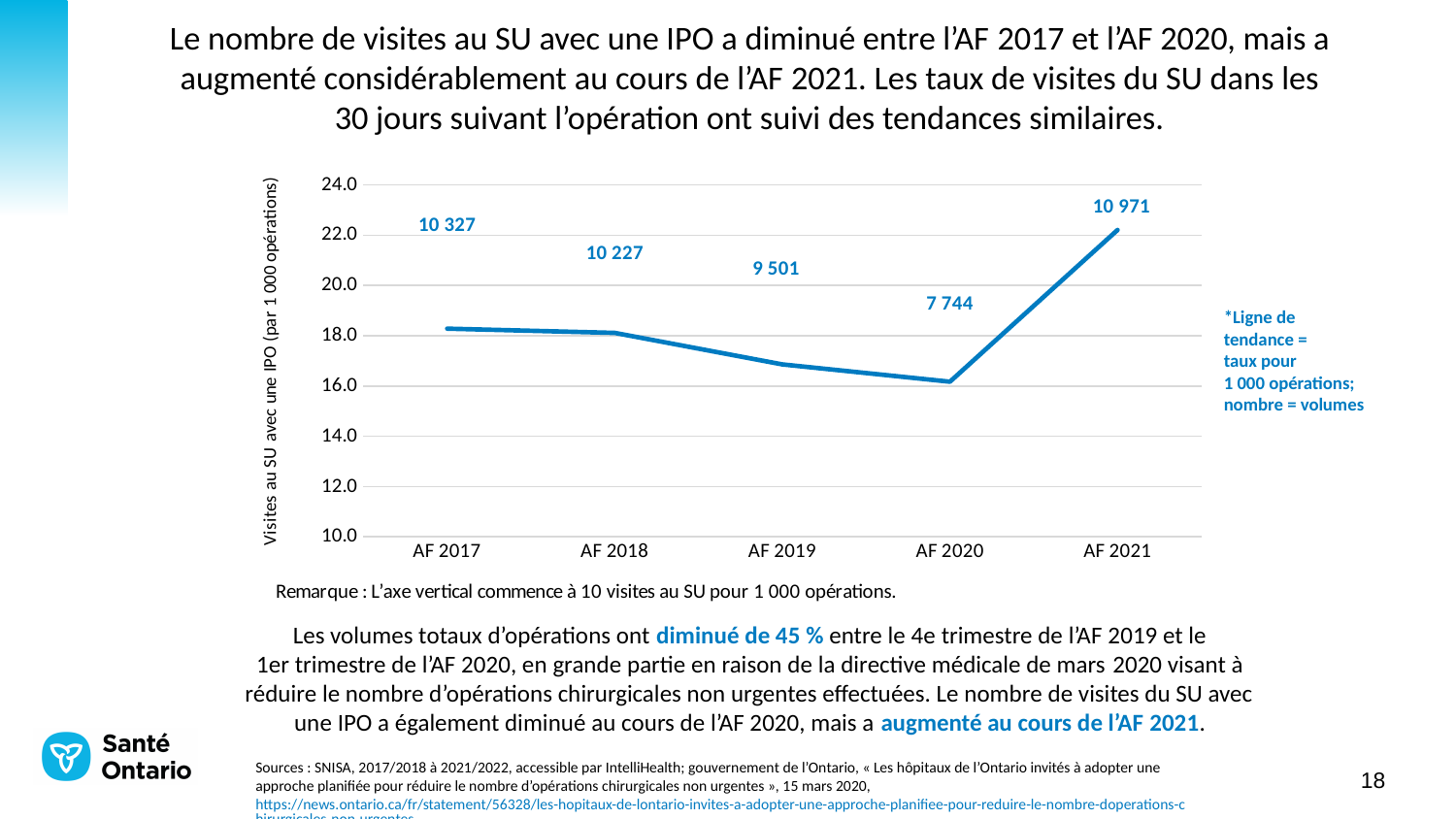
How many fiscal years are plotted on the x axis? 5 What volume (number of ED visits with a POI) is labelled for AF 2017? 10 327 Does the line rise or fall between AF 2017 and AF 2020? fall What volume is labelled for AF 2020? 7 744 What type of chart is shown on the slide? line chart What is the difference between the labelled volumes for AF 2021 and AF 2020? 3 227 What volume is labelled for AF 2021? 10 971 Is the rate (line value) for AF 2020 greater or less than 18.0? less Which fiscal year has the lowest labelled volume? AF 2020 Which fiscal year has the highest labelled volume? AF 2021 Which labelled volume is larger, AF 2018 or AF 2019? AF 2018 Is the rate (line value) for AF 2021 greater or less than 20.0? greater